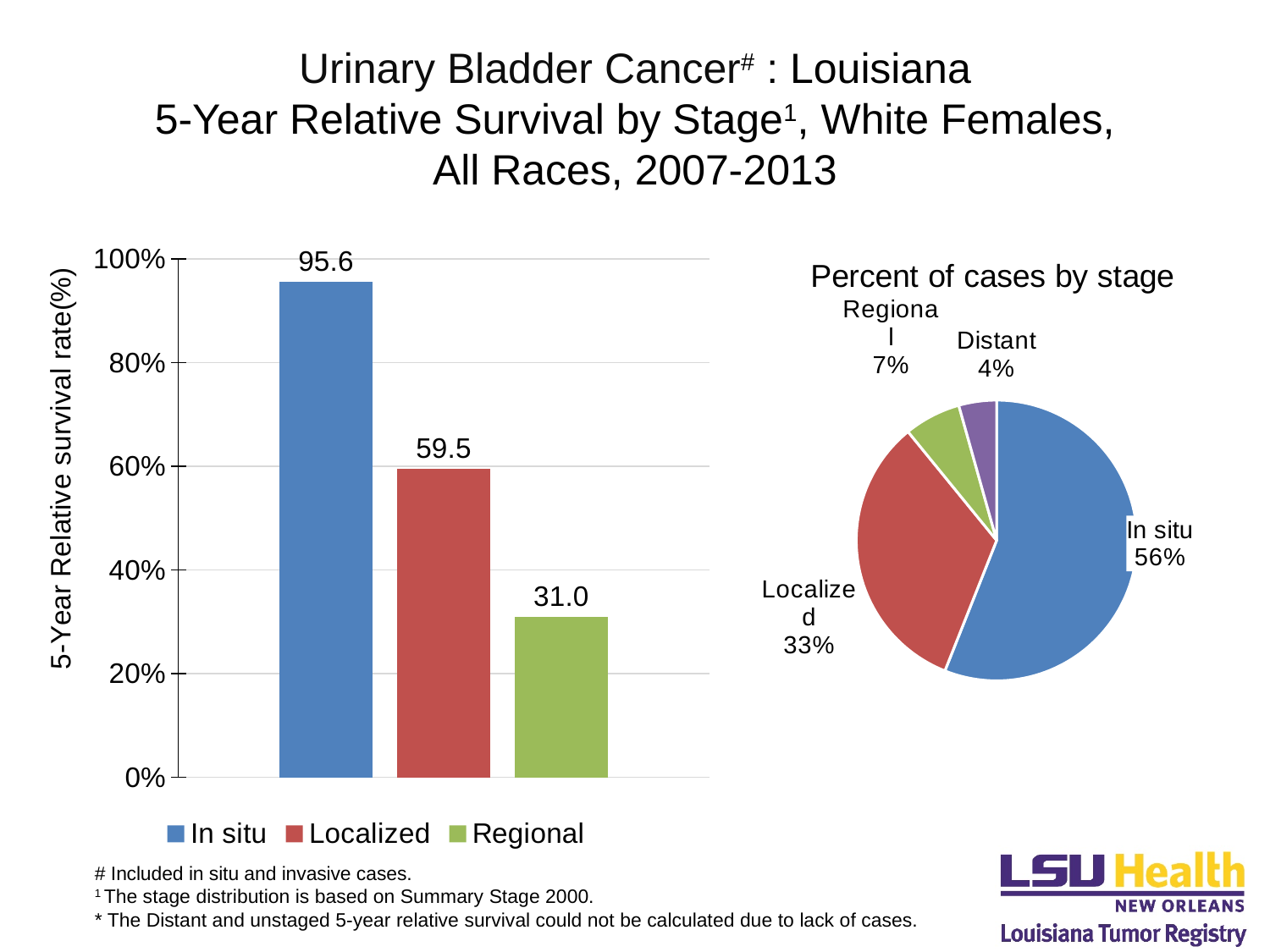
In the bar chart on the left, how many series does the legend list? 3 What kind of chart is the chart on the left of the slide? Bar chart In the bar chart on the left, what is the 5-year relative survival rate for In situ? 95.6 In the 'Percent of cases by stage' pie chart, how many slices are there? 4 In the bar chart on the left, which stage has the lowest 5-year relative survival rate? Regional In the 'Percent of cases by stage' pie chart, what share of cases are Distant? 4% In the bar chart on the left, what is the 5-year relative survival rate for Regional? 31.0 In the 'Percent of cases by stage' pie chart, which is larger, the Localized share or the Regional share? Localized In the 'Percent of cases by stage' pie chart, what share of cases are In situ? 56% In the bar chart on the left, what is the 5-year relative survival rate for Localized? 59.5 In the bar chart on the left, what is the difference between the In situ and Localized survival rates? 36.1 In the 'Percent of cases by stage' pie chart, which stage has the largest share of cases? In situ